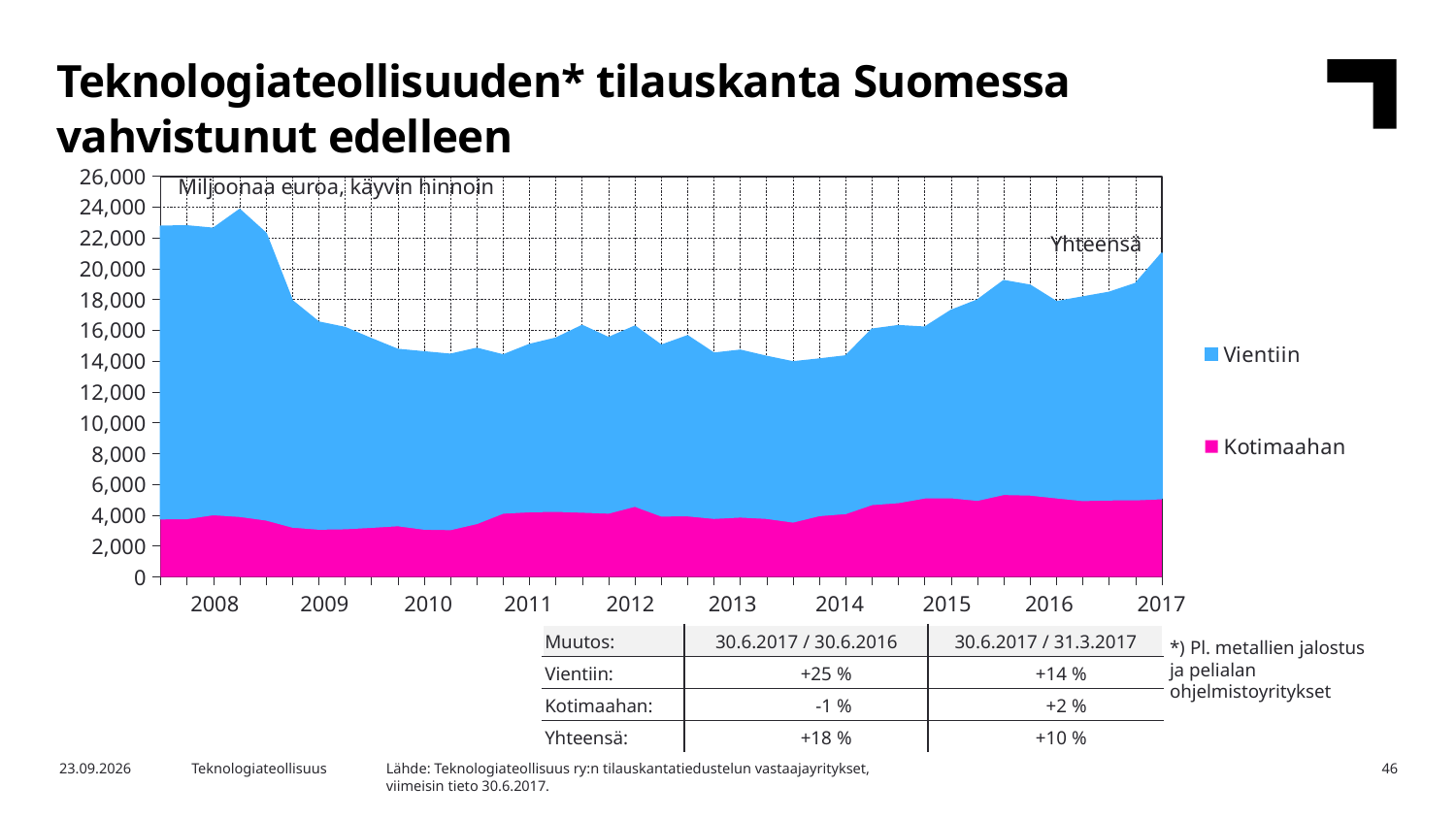
What kind of chart is shown on the slide? Area chart Is the Kotimaahan value in 2010 greater or less than 4,000? less What unit label is printed inside the chart area? Miljoonaa euroa, käyvin hinnoin Is the total (Yhteensä) value at the end of the series in 2017 greater or less than 20,000? greater Does the total (Yhteensä) value rise or fall from 2008 to 2010? fall Is the total (Yhteensä) value at the start of 2008 greater or less than 20,000? greater How many year labels are shown on the x axis? 10 Does the total (Yhteensä) value rise or fall from 2014 to 2017? rise What are the two series named in the chart legend? Vientiin and Kotimaahan How many series does the chart legend list? 2